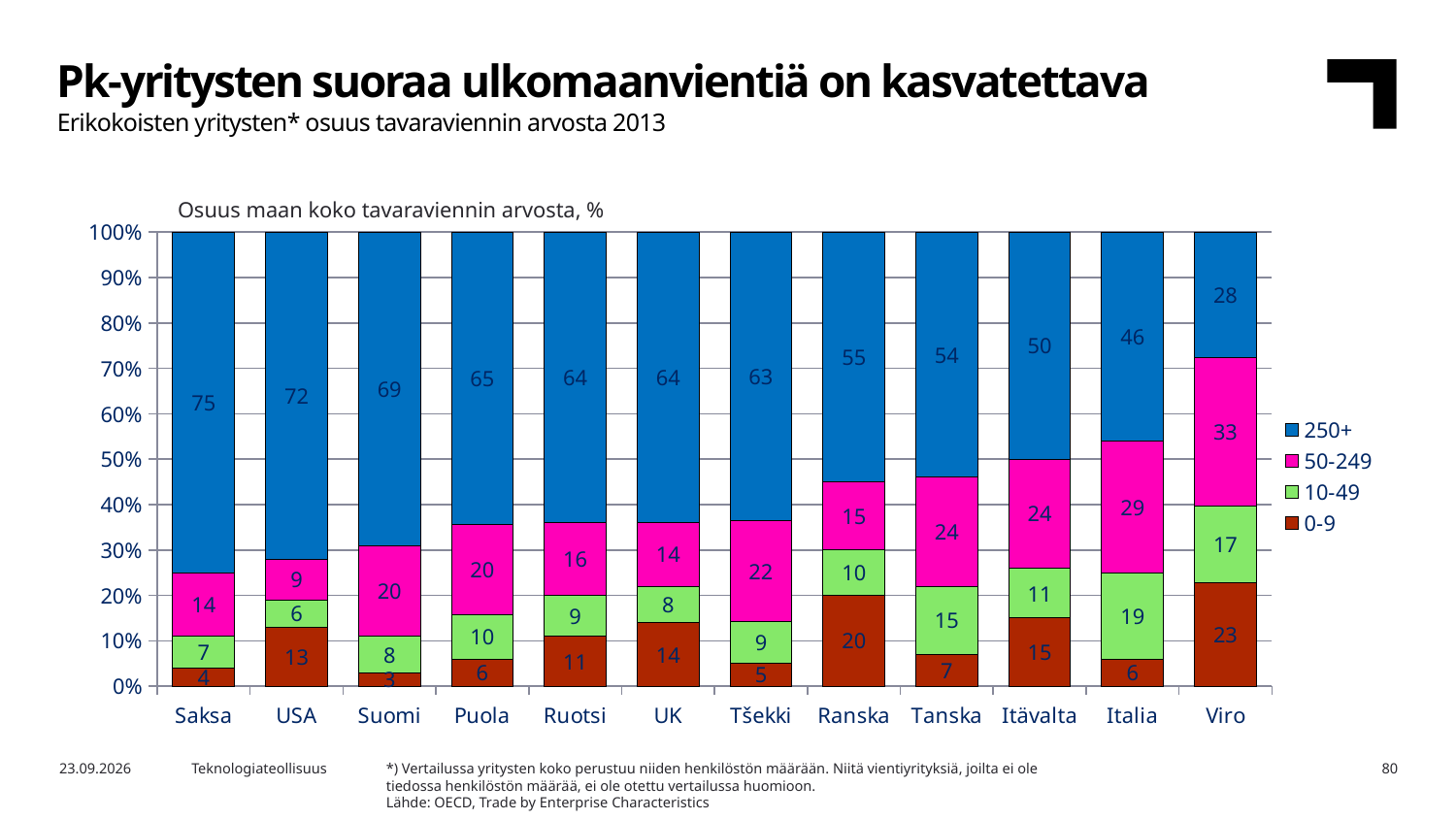
Which is larger, the 0-9 value for Ranska or the 0-9 value for Tanska? Ranska How many countries are shown on the x axis? 12 What is the title printed above the chart? Osuus maan koko tavaraviennin arvosta, % Which country has the lowest value for the 250+ series? Viro What is the value of the 0-9 series for Viro? 23 What is the value of the 50-249 series for Italia? 29 How many series does the legend list? 4 Which country has the highest value for the 250+ series? Saksa What is the difference between the 250+ values for Saksa and Viro? 47 Do the values of the 250+ series rise or fall moving from Saksa to Viro along the x axis? Fall What kind of chart is shown on the slide? Stacked bar chart What is the value of the 250+ series for Saksa? 75